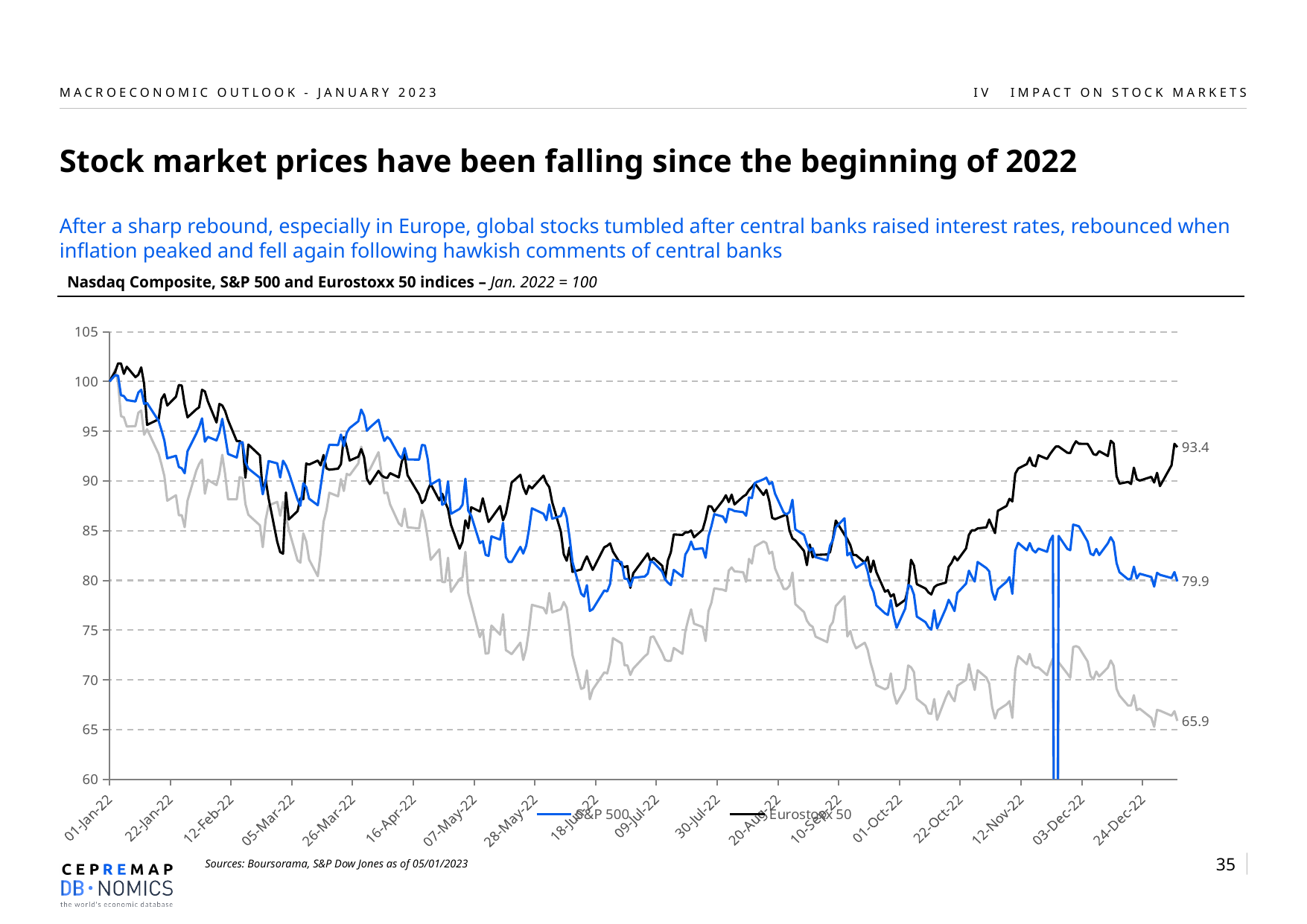
Which index has the highest value at the end of the series, the S&P 500 or the Eurostoxx 50? Eurostoxx 50 What is the lowest of the three end-of-series values labelled on the chart? 65.9 What is the final value shown for the Eurostoxx 50 index at the end of the series? 93.4 What is the difference between the end-of-series values of the Eurostoxx 50 (93.4) and the S&P 500 (79.9)? 13.5 Is the end-of-series value of the Eurostoxx 50 greater or less than 90? greater Is the end-of-series value of the S&P 500 greater or less than 80? less What base value are the indices set to in January 2022, according to the chart title? 100 What type of chart is shown on the slide? line chart What is the difference between the highest (93.4) and lowest (65.9) end-of-series values labelled on the chart? 27.5 What is the final value shown for the S&P 500 index at the end of the series? 79.9 What colour is the line for the S&P 500 in the chart? blue Overall, do the index values rise or fall from January 2022 to the end of the series? fall